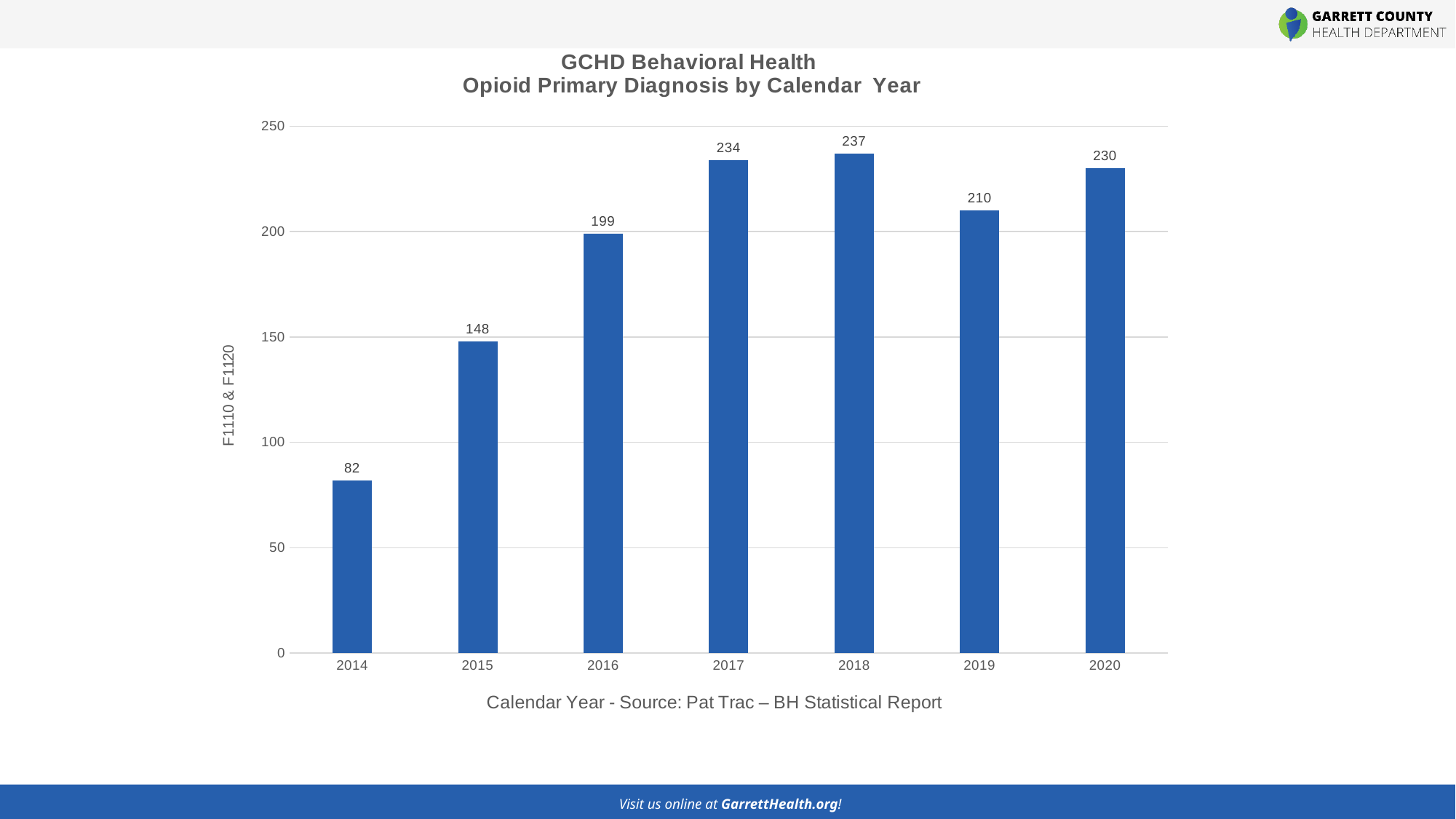
Is the value for 2016 greater or less than 150? greater What is the difference between the values for 2018 and 2019? 27 What is the value for 2014? 82 Which year has the lowest value? 2014 How many years are shown on the x axis? 7 Which year has the highest value? 2018 What is the difference between the values for 2015 and 2014? 66 What kind of chart is shown on the slide? bar chart What is the value for 2020? 230 What is the value for 2017? 234 What is the label of the y axis? F1110 & F1120 Which is larger, the value for 2016 or the value for 2019? 2019